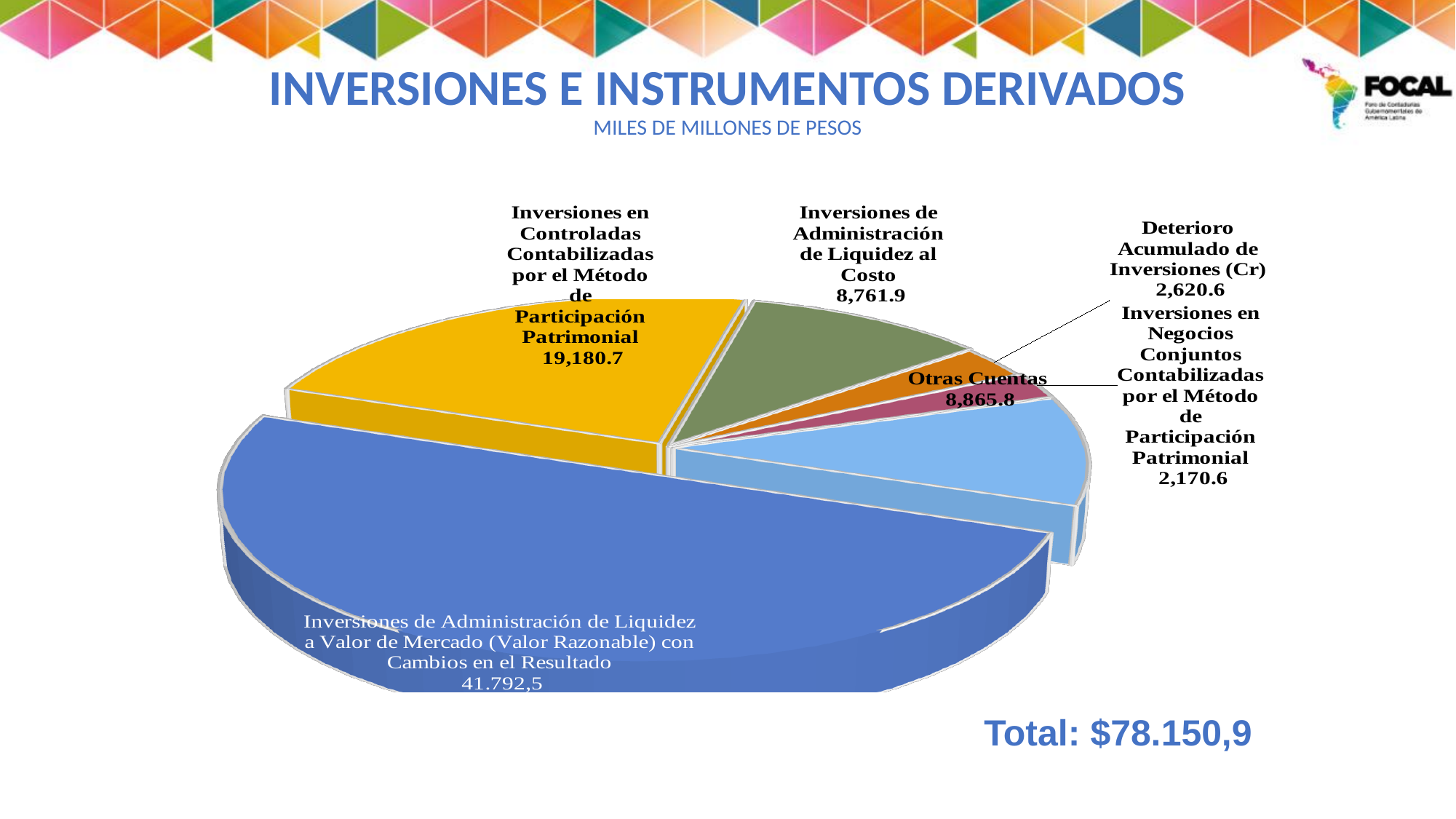
What is the value for Inversiones en Controladas Contabilizadas por el Método de Participación Patrimonial? 19,180.7 Which category has the smallest value in the pie chart? Inversiones en Negocios Conjuntos Contabilizadas por el Método de Participación Patrimonial Which category has the largest slice of the pie? Inversiones de Administración de Liquidez a Valor de Mercado (Valor Razonable) con Cambios en el Resultado How many slices does the pie chart have? 6 In what units are the values on the chart expressed, according to the subtitle? Miles de millones de pesos What is the value for Inversiones de Administración de Liquidez al Costo? 8,761.9 What total is printed below the pie chart? $78.150,9 What is the value for Deterioro Acumulado de Inversiones (Cr)? 2,620.6 What type of chart is shown on the slide? Pie chart What is the difference between Inversiones en Controladas Contabilizadas por el Método de Participación Patrimonial and Inversiones de Administración de Liquidez al Costo? 10,418.8 Which is larger: Otras Cuentas or Inversiones de Administración de Liquidez al Costo? Otras Cuentas What is the value for Otras Cuentas? 8,865.8